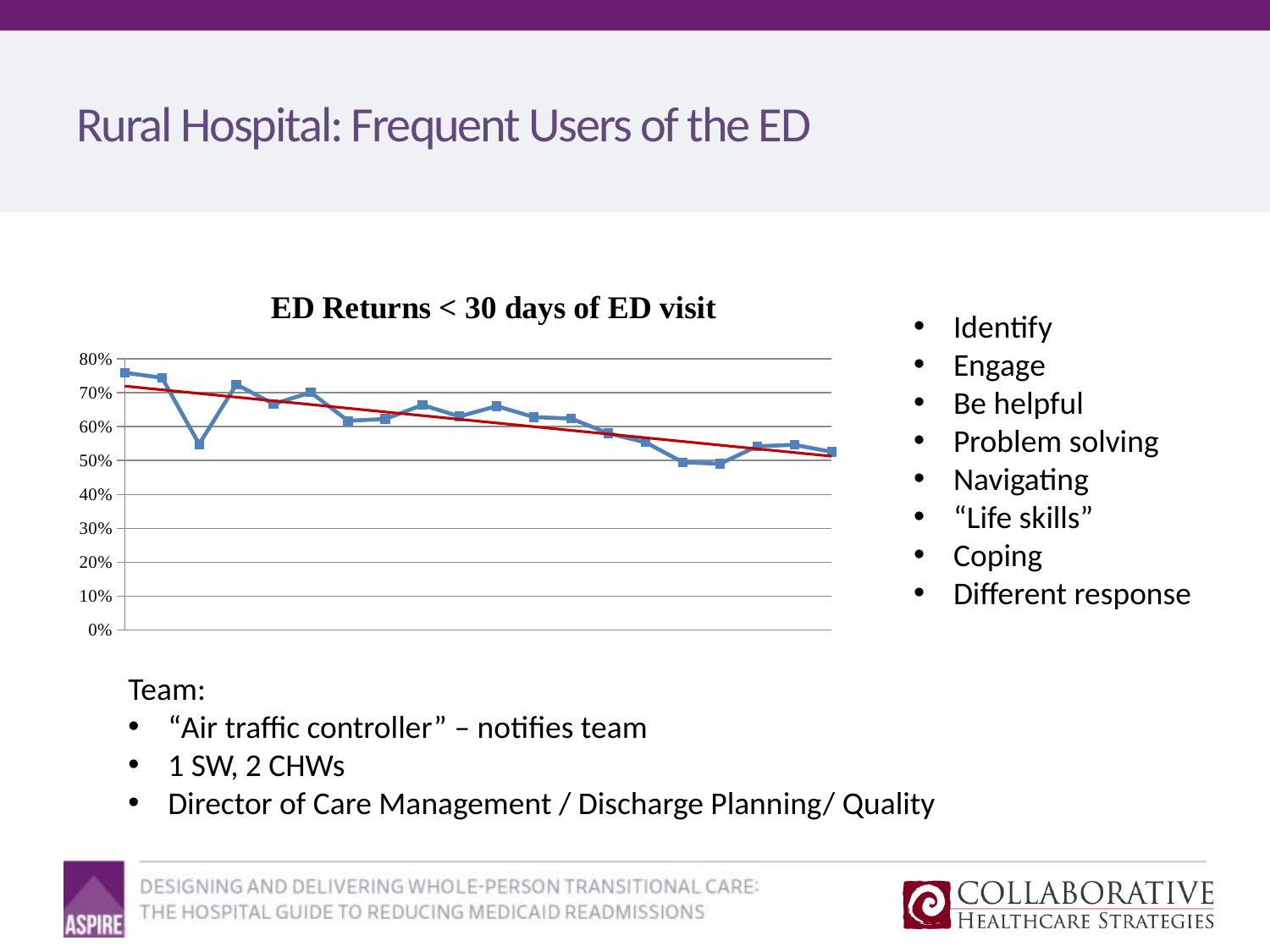
What is the title of the chart? ED Returns < 30 days of ED visit Is the value of the fourth data point greater or less than 70%? greater How many data points are plotted on the line? 20 Do the values in the chart generally rise or fall from left to right? fall What kind of chart is shown on the slide? line chart Is the value of the last data point greater or less than 60%? less What is the highest value shown on the vertical axis? 80% Is the value of the first data point greater or less than 70%? greater Is the value of the first data point greater or less than the value of the last data point? greater Which data point has the highest value in the chart? the first point